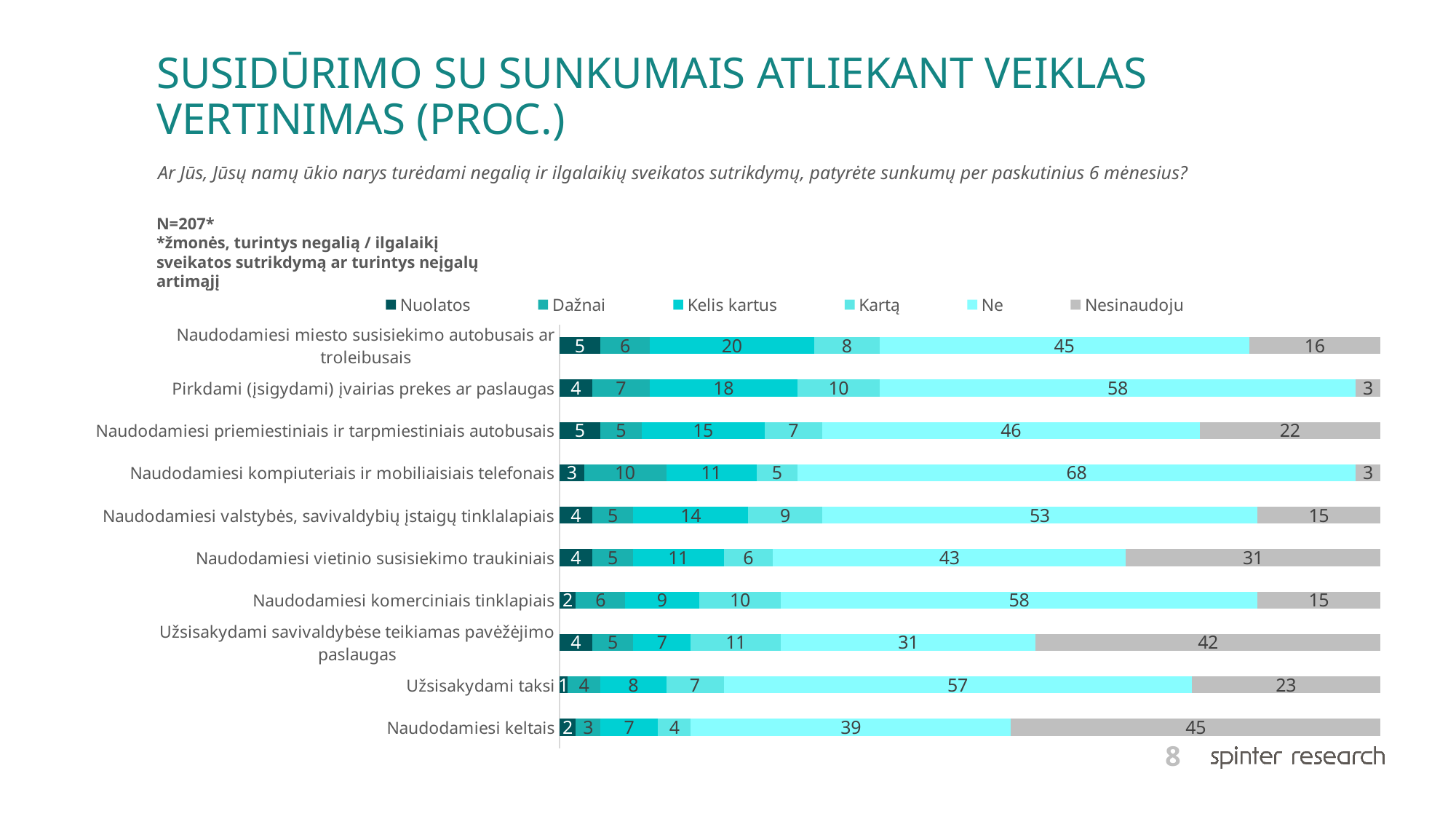
What kind of chart is shown on the slide? Stacked bar chart Which category has the highest value for "Nesinaudoju"? Naudodamiesi keltais Which category has the highest value for "Ne"? Naudodamiesi kompiuteriais ir mobiliaisiais telefonais Which category has the lowest value for "Nuolatos"? Užsisakydami taksi How many series does the legend list? 6 What is the difference between the "Nesinaudoju" values for "Naudodamiesi vietinio susisiekimo traukiniais" and "Naudodamiesi miesto susisiekimo autobusais ar troleibusais"? 15 How many categories are shown in the chart? 10 What is the value of "Ne" for "Naudodamiesi kompiuteriais ir mobiliaisiais telefonais"? 68 What is the total of the stacked bar for "Naudodamiesi miesto susisiekimo autobusais ar troleibusais"? 100 What is the value of "Nesinaudoju" for "Užsisakydami savivaldybėse teikiamas pavėžėjimo paslaugas"? 42 What is the value of "Kelis kartus" for "Naudodamiesi miesto susisiekimo autobusais ar troleibusais"? 20 Which is larger: the "Kelis kartus" value for "Pirkdami (įsigydami) įvairias prekes ar paslaugas" or for "Naudodamiesi priemiestiniais ir tarpmiestiniais autobusais"? Pirkdami (įsigydami) įvairias prekes ar paslaugas